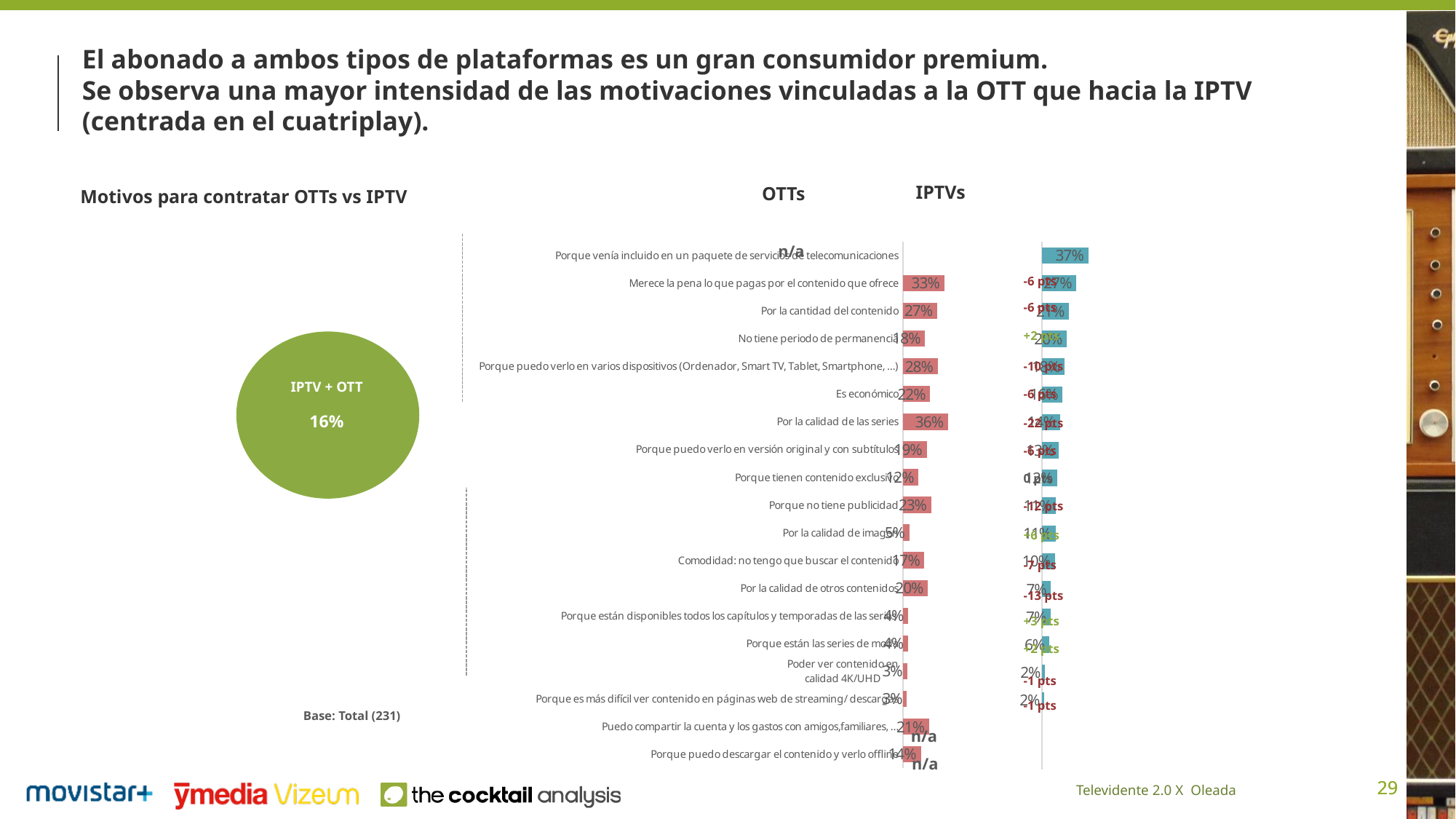
In the 'Motivos para contratar OTTs vs IPTV' chart, what is the OTTs value for 'Por la cantidad del contenido'? 27% In the 'Motivos para contratar OTTs vs IPTV' chart, which is larger for OTTs: 'Por la calidad de las series' or 'Porque puedo verlo en varios dispositivos (Ordenador, Smart TV, Tablet, Smartphone, ...)'? Por la calidad de las series What kind of chart is used to show the 'Motivos para contratar OTTs vs IPTV' data? bar chart In the 'Motivos para contratar OTTs vs IPTV' chart, what is the IPTVs value for 'Porque venía incluido en un paquete de servicios de telecomunicaciones'? 37% How many series (column groups) does the 'Motivos para contratar OTTs vs IPTV' chart compare? 2 In the 'Motivos para contratar OTTs vs IPTV' chart, what is the difference between the OTTs value (33%) and the IPTVs value (27%) for 'Merece la pena lo que pagas por el contenido que ofrece'? 6 pts In the 'Motivos para contratar OTTs vs IPTV' chart, which motive has the highest IPTVs value? Porque venía incluido en un paquete de servicios de telecomunicaciones In the 'Motivos para contratar OTTs vs IPTV' chart, what is the OTTs value for 'Merece la pena lo que pagas por el contenido que ofrece'? 33% What percentage is shown in the green circle labelled 'IPTV + OTT'? 16% In the 'Motivos para contratar OTTs vs IPTV' chart, what is the OTTs value for 'Por la calidad de las series'? 36% How many motives (categories) are listed in the 'Motivos para contratar OTTs vs IPTV' chart? 19 In the 'Motivos para contratar OTTs vs IPTV' chart, which motive has the highest OTTs value? Por la calidad de las series